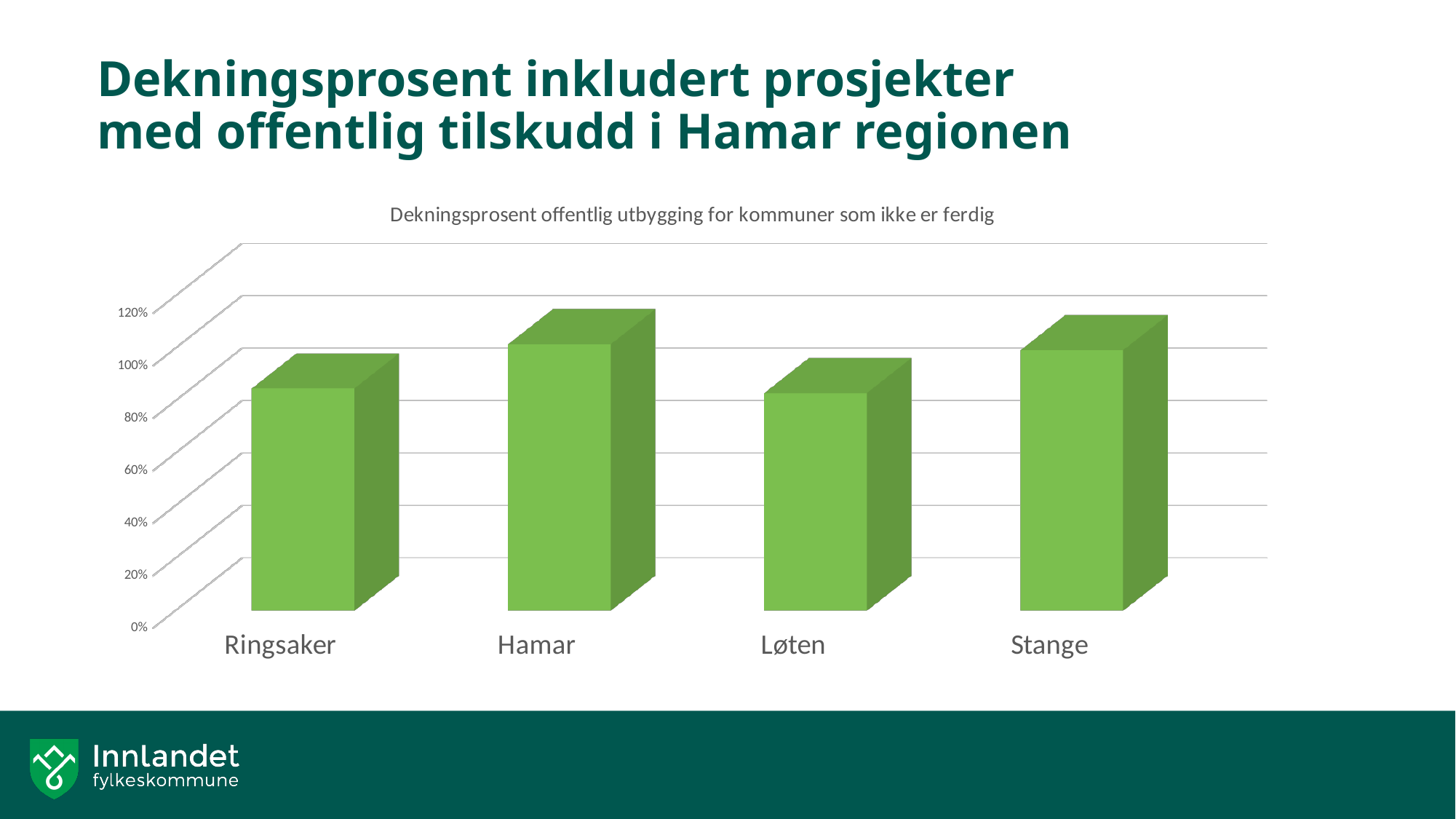
Is the value for Hamar greater or less than 120%? less What colour are the bars in the chart? Green What is the title of the chart? Dekningsprosent offentlig utbygging for kommuner som ikke er ferdig Is the value for Hamar greater or less than 80%? greater What kind of chart is shown on the slide? Bar chart Is the value for Stange greater or less than 80%? greater Which is larger, the value for Hamar or the value for Ringsaker? Hamar How many municipalities (categories) are shown on the x axis of the chart? 4 Which is larger, the value for Stange or the value for Løten? Stange